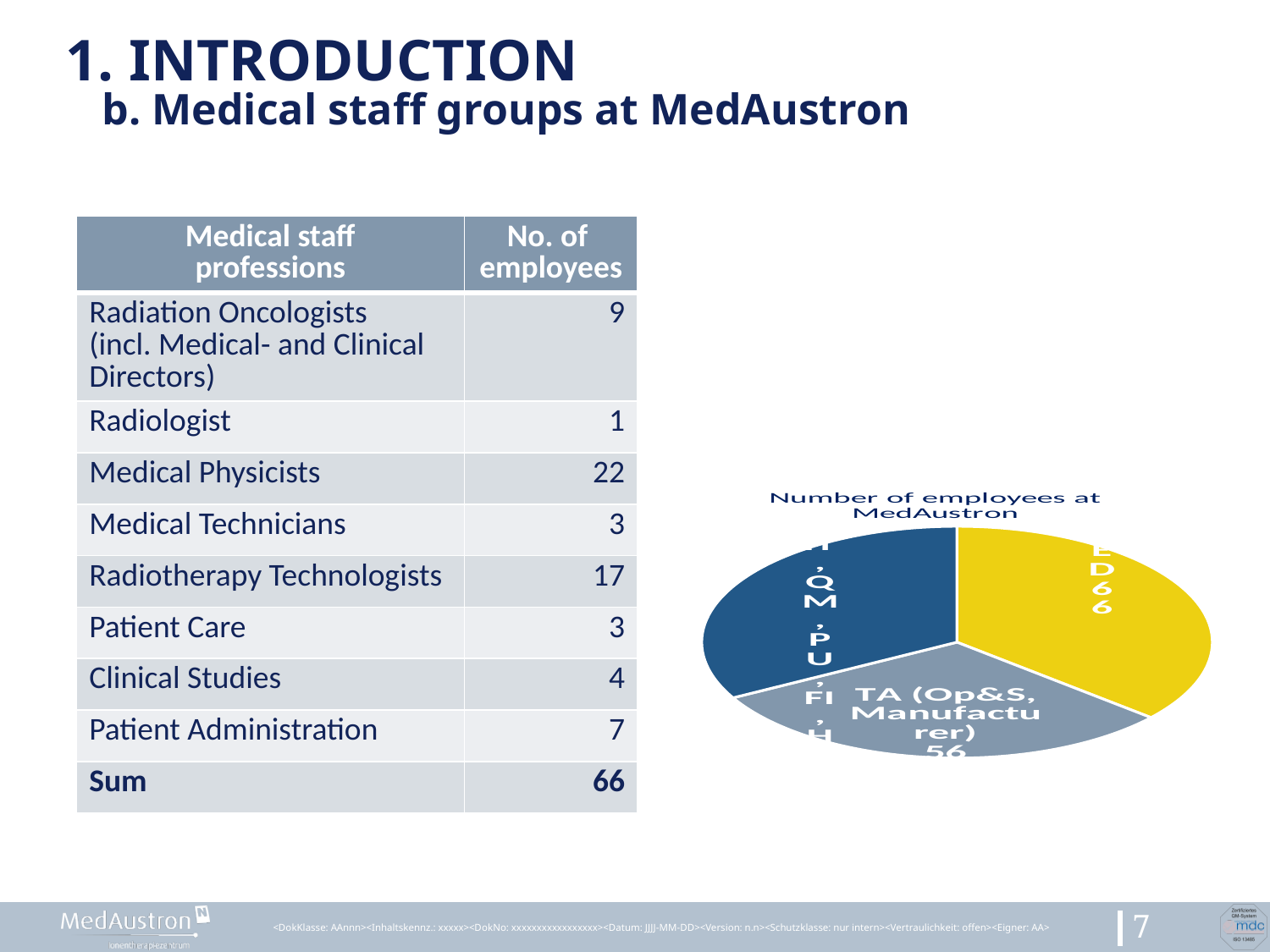
How many slices does the pie chart have? 3 What value is printed on the yellow slice of the pie chart? 66 What colour is the TA (Op&S, Manufacturer) slice in the pie chart? grey In the pie chart, which is larger: the value on the yellow slice or the value for TA (Op&S, Manufacturer)? the yellow slice What kind of chart is shown on the slide? pie chart What is the title of the pie chart? Number of employees at MedAustron In the pie chart, what value is shown for TA (Op&S, Manufacturer)? 56